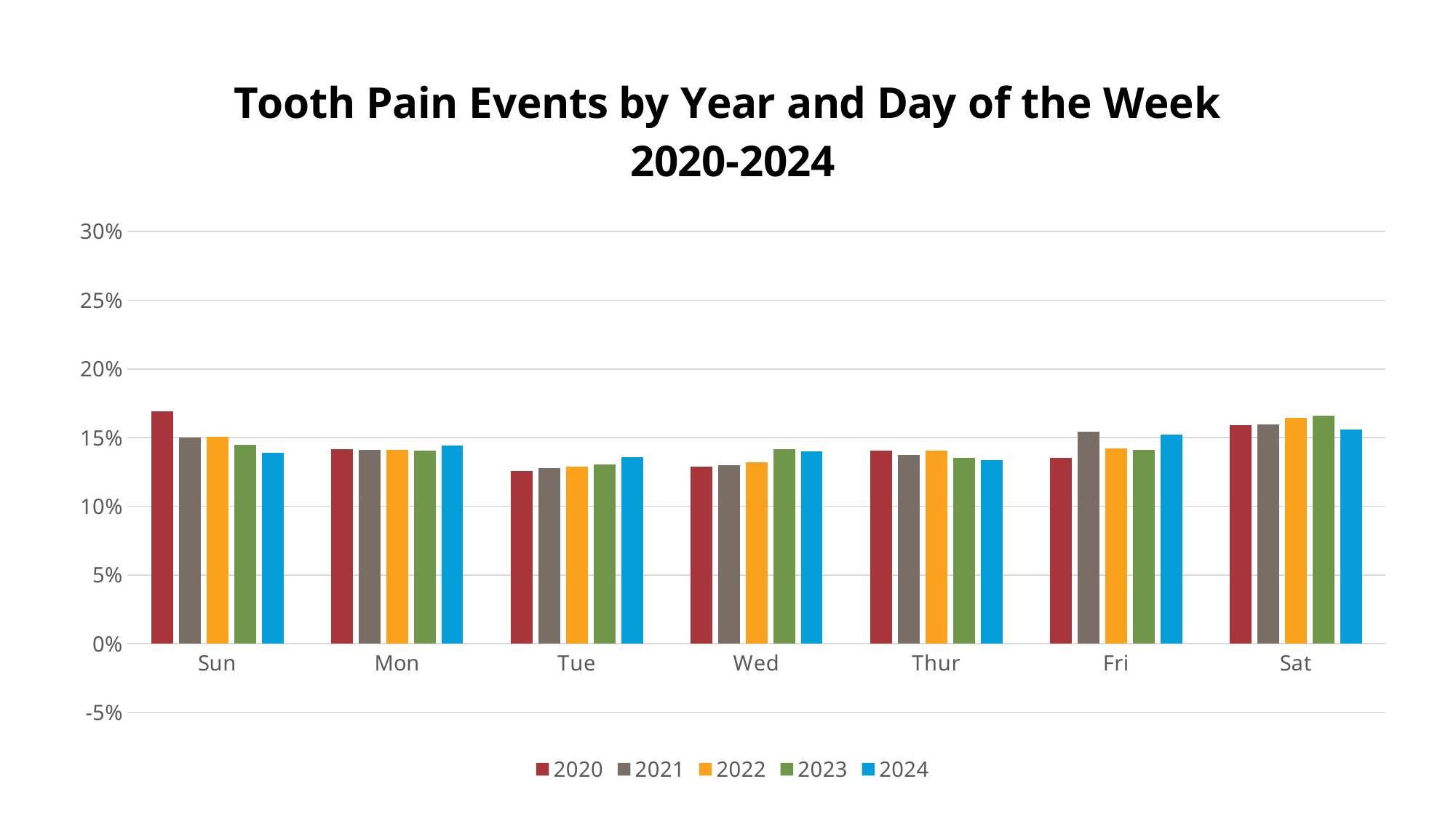
Is the value for Wed in 2020 greater or less than 10%? greater What is the title of the chart? Tooth Pain Events by Year and Day of the Week 2020-2024 How many series does the legend list? 5 How many days of the week are shown on the x axis? 7 Is the value for Sun in 2020 greater or less than 15%? greater Is the value for Tue in 2020 greater or less than 15%? less For Sun, which year has the highest value? 2020 Which is larger: the value for Sun in 2020 or the value for Sun in 2024? Sun in 2020 What kind of chart is shown on the slide? bar chart Which day has the highest value for the 2020 series? Sun Which day has the highest value for the 2023 series? Sat